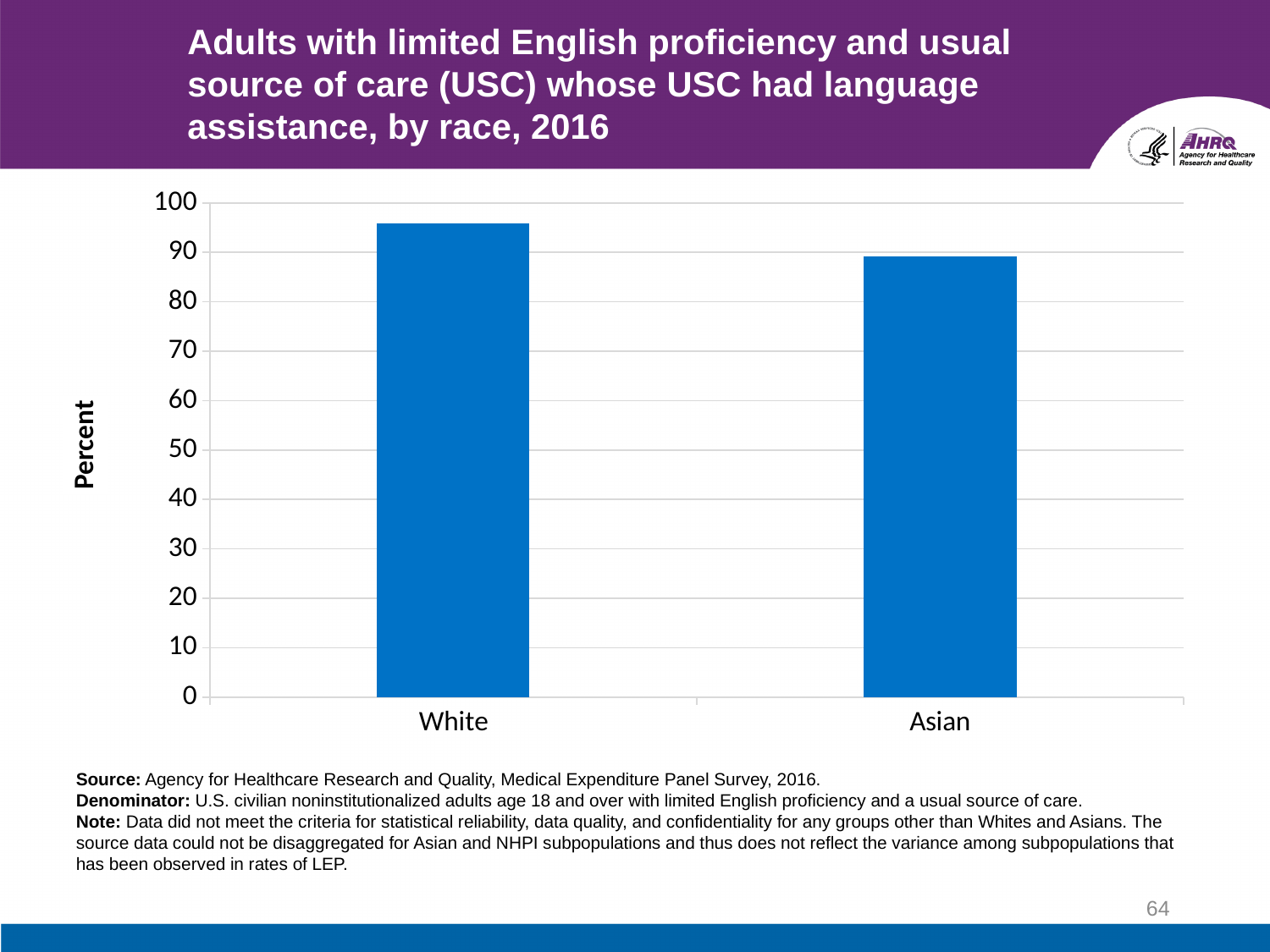
Which is larger, the value for White or the value for Asian? White What is the label on the vertical axis of the chart? Percent Which race category has the highest percentage in the chart? White How many race categories are shown on the x axis of the chart? 2 What is the maximum value shown on the vertical axis of the chart? 100 Is the value for White greater or less than 90? greater Is the value for Asian greater or less than 80? greater Which race category has the lowest percentage in the chart? Asian Is the value for Asian greater or less than 70? greater What kind of chart is shown on the slide? bar chart